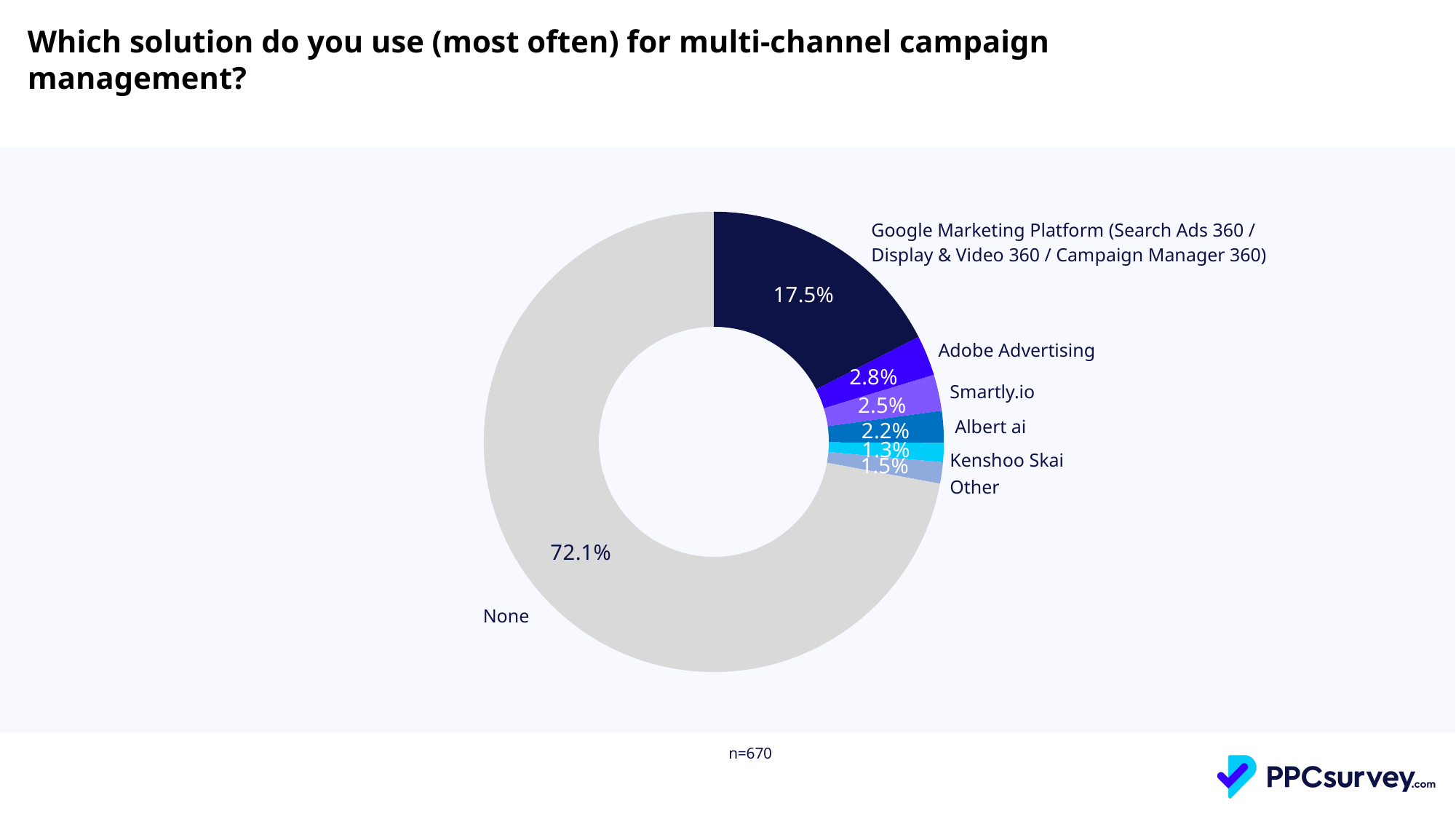
What share of respondents use Smartly.io? 2.5% Which category has the largest slice of the chart? None What share of respondents use Adobe Advertising? 2.8% How many slices does the chart have? 7 Which is larger, the share for Albert ai or the share for Other? Albert ai Which category has the smallest slice of the chart? Kenshoo Skai What share of respondents answered "None"? 72.1% What is the sample size (n) shown below the chart? n=670 What share of respondents use Google Marketing Platform (Search Ads 360 / Display & Video 360 / Campaign Manager 360)? 17.5% What share of respondents use Kenshoo Skai? 1.3% What is the difference in percentage points between the "None" slice and the Google Marketing Platform slice? 54.6 What kind of chart is shown on the slide? Pie chart (donut)